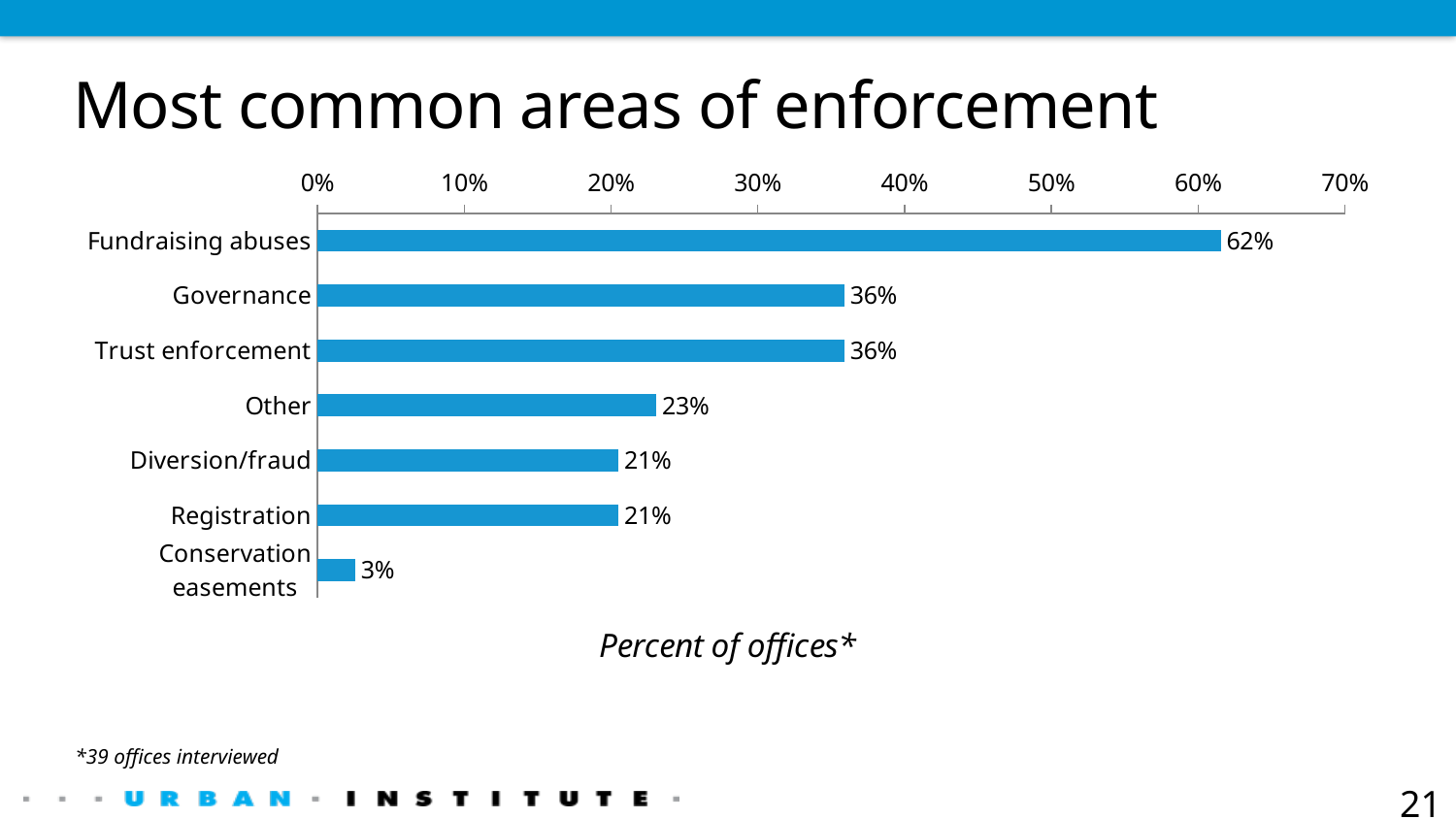
How many areas of enforcement are shown in the chart? 7 What is the difference between the values for Other and Registration? 2% What percent of offices reported Fundraising abuses as an area of enforcement? 62% What is the title of the chart? Most common areas of enforcement Which is larger, the value for Trust enforcement or the value for Other? Trust enforcement What is the value for Diversion/fraud? 21% What is the value for Conservation easements? 3% Which area of enforcement has the highest percent of offices? Fundraising abuses Which area of enforcement has the lowest percent of offices? Conservation easements What is the value for Governance? 36% What is the difference between the values for Fundraising abuses and Governance? 26% What kind of chart is shown on the slide? Bar chart